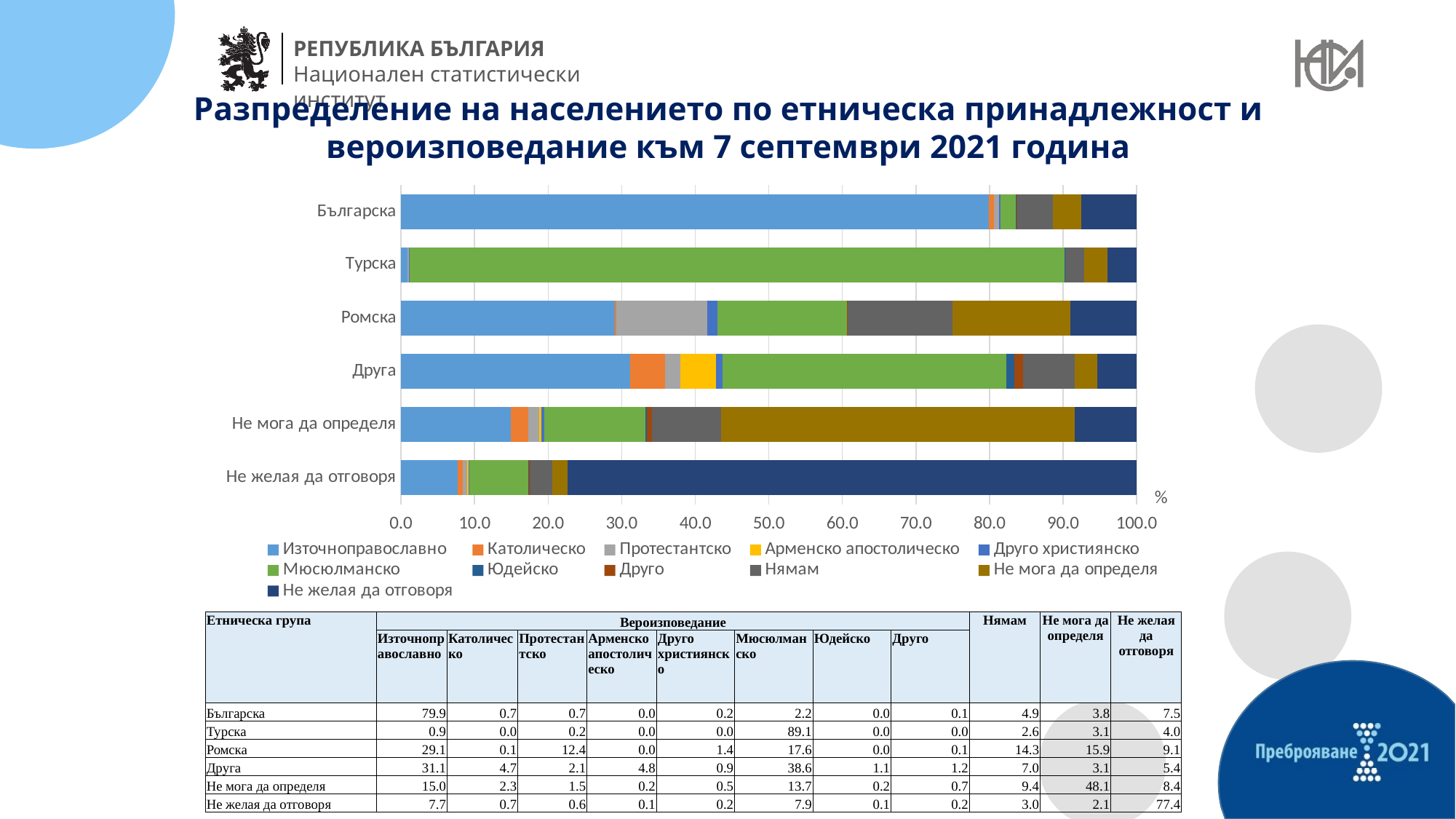
What is the value of Мюсюлманско for the Турска group? 89.1 Which ethnic group has the largest Протестантско segment? Ромска Which ethnic group has the largest Не желая да отговоря segment? Не желая да отговоря For the Друга group, which is larger: Мюсюлманско or Източноправославно? Мюсюлманско For the Ромска group, what is the difference between the Източноправославно value and the Мюсюлманско value? 11.5 How many series does the chart legend list? 11 What is the value of Източноправославно for the Българска group? 79.9 Is the Източноправославно value for the Българска group greater or less than 70.0? greater How many ethnic groups (categories) are plotted on the y axis of the chart? 6 What is the value of Не мога да определя for the Не мога да определя ethnic group? 48.1 What kind of chart is shown on the slide? Stacked bar chart What unit is shown at the end of the x axis of the chart? %